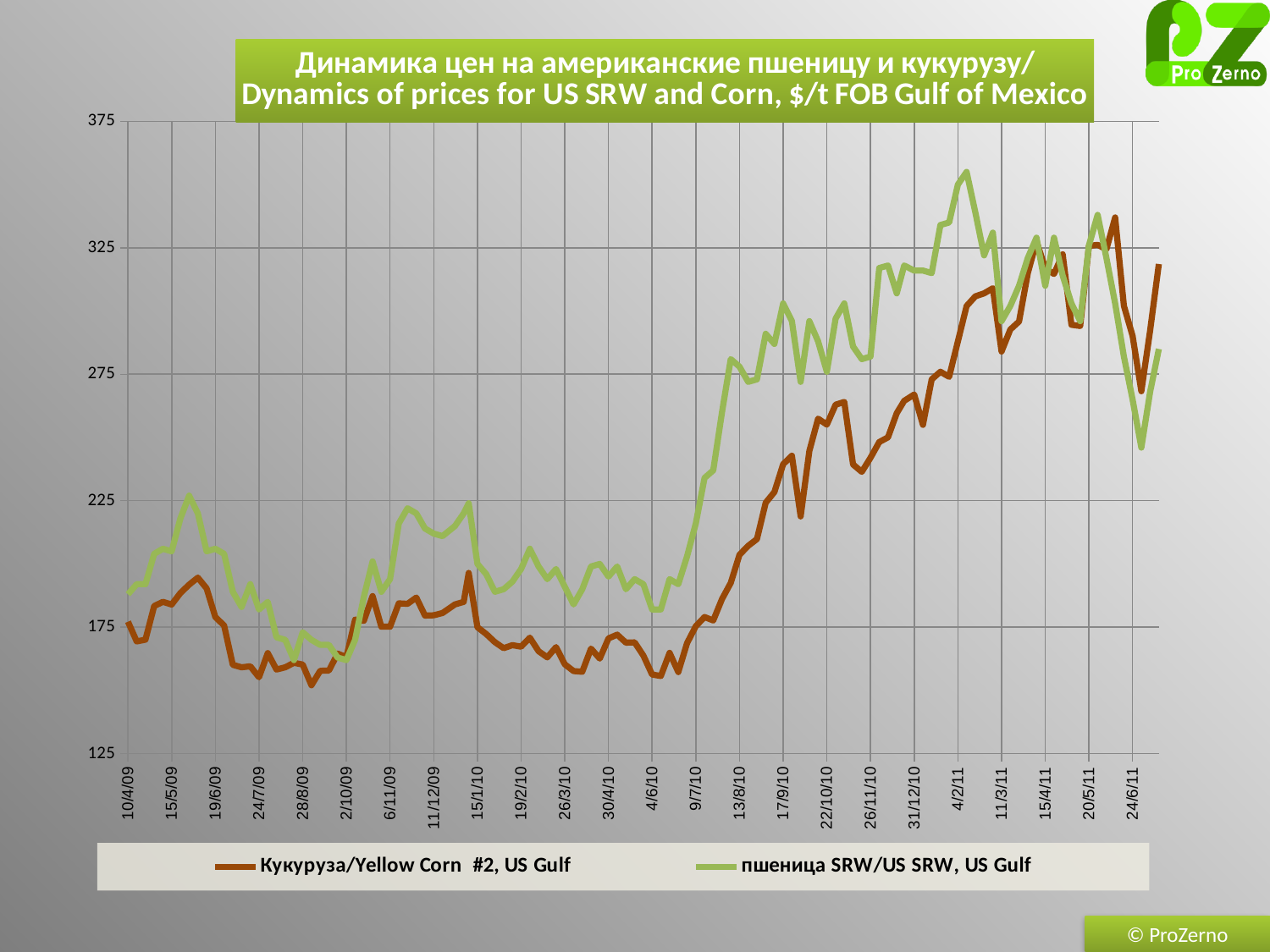
How many date labels are shown on the horizontal axis? 24 How many series does the legend list? 2 Which series has the higher value at 9/7/10, Кукуруза/Yellow Corn #2 or пшеница SRW/US SRW? пшеница SRW/US SRW, US Gulf Is the value for Кукуруза/Yellow Corn #2, US Gulf at 4/6/10 greater or less than 175? less Is the value for Кукуруза/Yellow Corn #2, US Gulf at 4/2/11 greater or less than 275? greater What kind of chart is shown on the slide? line chart Which series reaches the highest value anywhere on the chart? пшеница SRW/US SRW, US Gulf Does the Кукуруза/Yellow Corn #2, US Gulf series rise or fall between 4/6/10 and 4/2/11? rise Is the value for пшеница SRW/US SRW, US Gulf at 4/2/11 greater or less than 325? greater What is the highest value shown on the vertical axis? 375 Which series is drawn in green according to the legend? пшеница SRW/US SRW, US Gulf